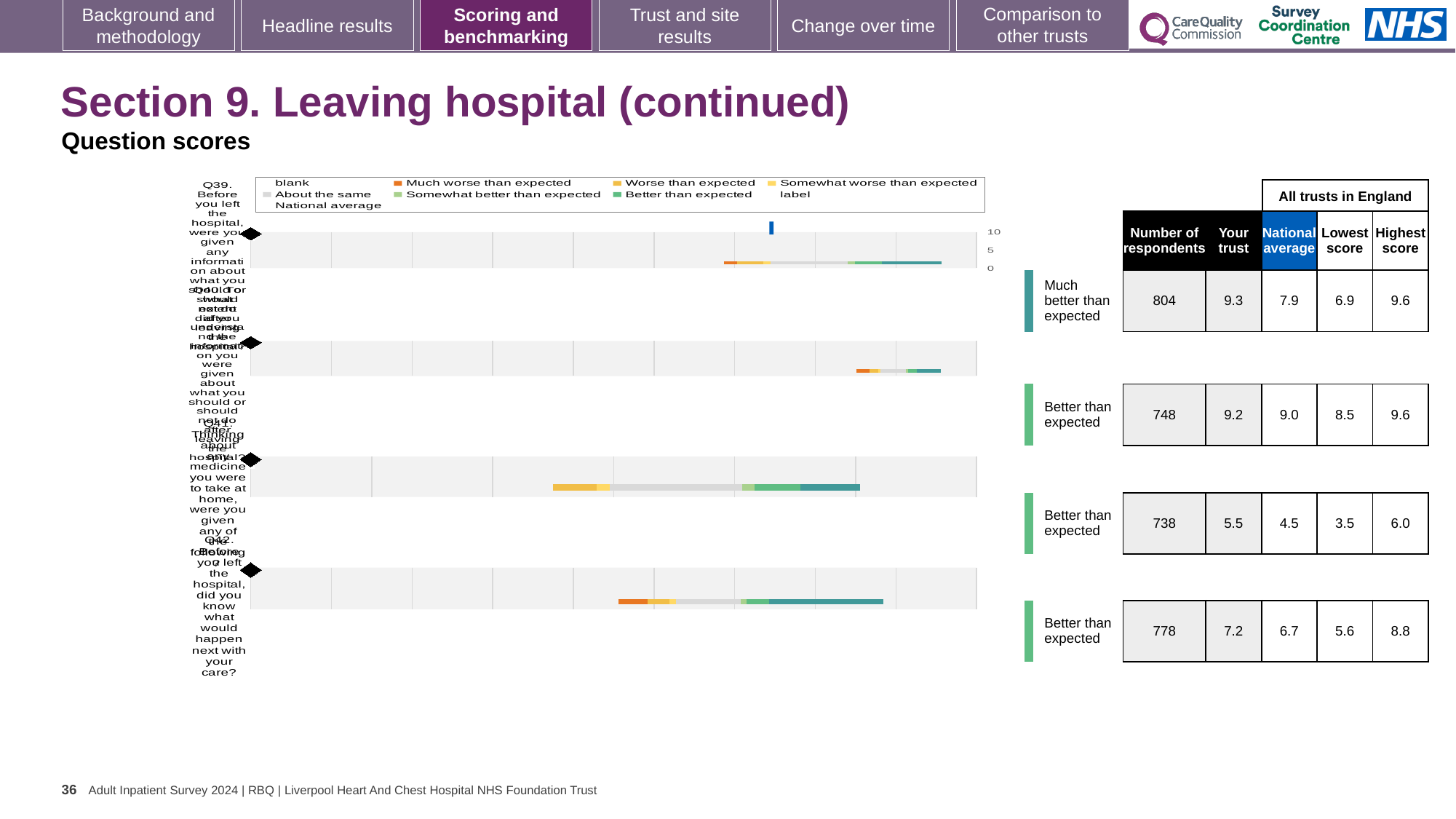
For Q39, which is larger: the 'Your trust' score or the national average? Your trust What type of chart is used to show the question scores on this slide? bar chart Which row of the chart has the lowest 'Your trust' score? the third row (5.5) For Q39, what is the difference between the highest score and the lowest score across all trusts in England? 2.7 What is the number of respondents for Q39, the first row of the chart? 804 What is the 'Your trust' score for Q42, the last row of the chart? 7.2 What is the national average score for Q39, the first row of the chart? 7.9 What is the 'Your trust' score for Q39, the first row of the chart? 9.3 What benchmark rating is shown for Q39 (the first row of the chart)? Much better than expected How many questions (rows) are plotted in the question scores chart? 4 What is the number of respondents for Q42, the last row of the chart? 778 In the chart legend, what colour represents 'Much worse than expected'? orange